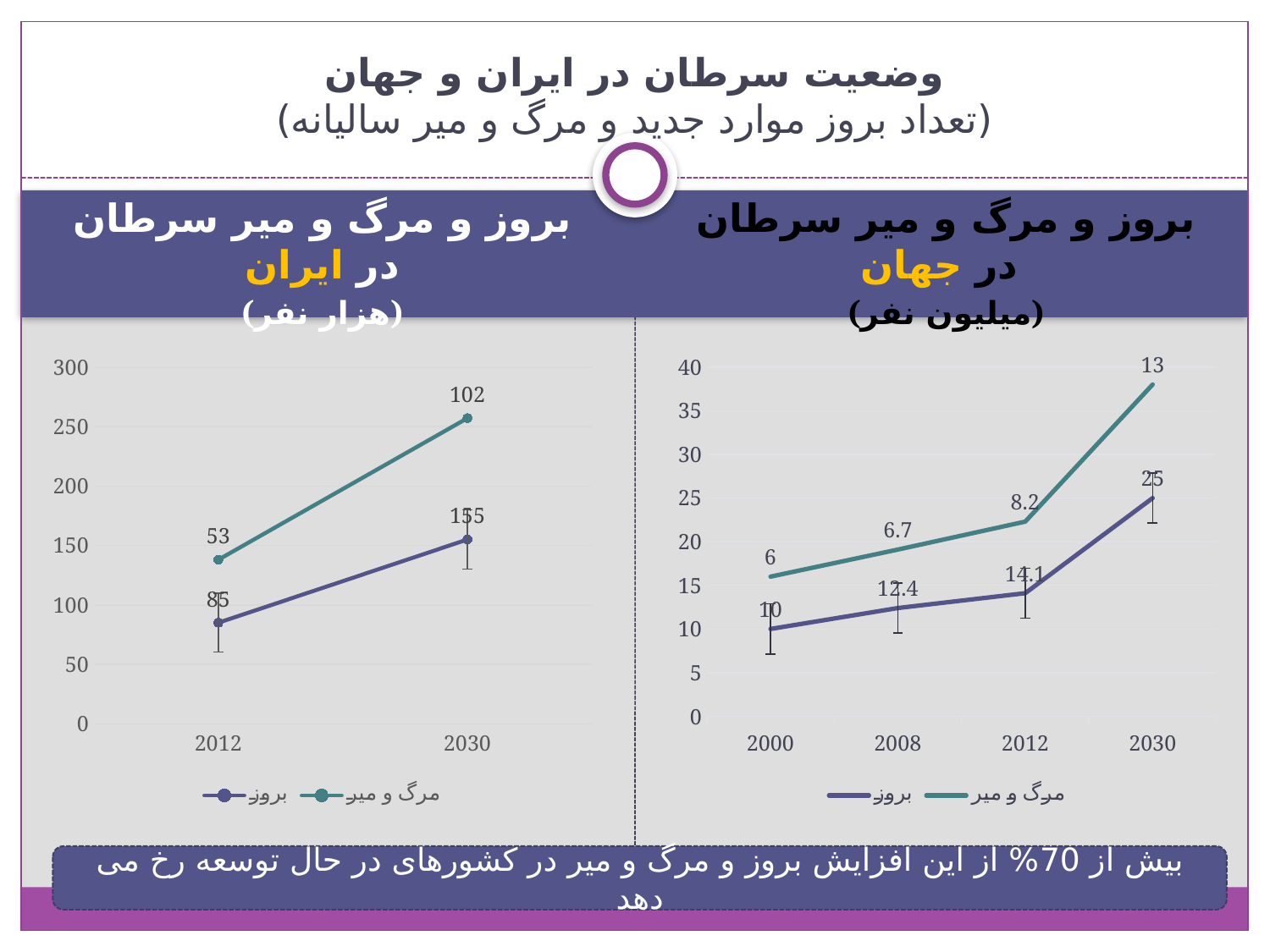
In the left chart (cancer in Iran), what is the value of مرگ و میر for 2030? 102 In the right chart (cancer in the world), does the بروز series rise or fall from 2000 to 2030? rise In the right chart (cancer in the world), what is the value of بروز for 2008? 12.4 In the left chart (cancer in Iran), how many years are shown on the x axis? 2 In the right chart (cancer in the world), what is the value of مرگ و میر for 2030? 13 What type of chart is the right chart (cancer in the world)? line chart In the left chart (cancer in Iran), what is the value of مرگ و میر for 2012? 53 In the right chart (cancer in the world), how many years are shown on the x axis? 4 In the right chart (cancer in the world), what is the value of مرگ و میر for 2012? 8.2 In the left chart (cancer in Iran), what is the value of بروز for 2030? 155 In the left chart (cancer in Iran), by how much does the بروز value increase from 2012 to 2030? 70 In the right chart (cancer in the world), what is the difference between the بروز values for 2030 and 2000? 15